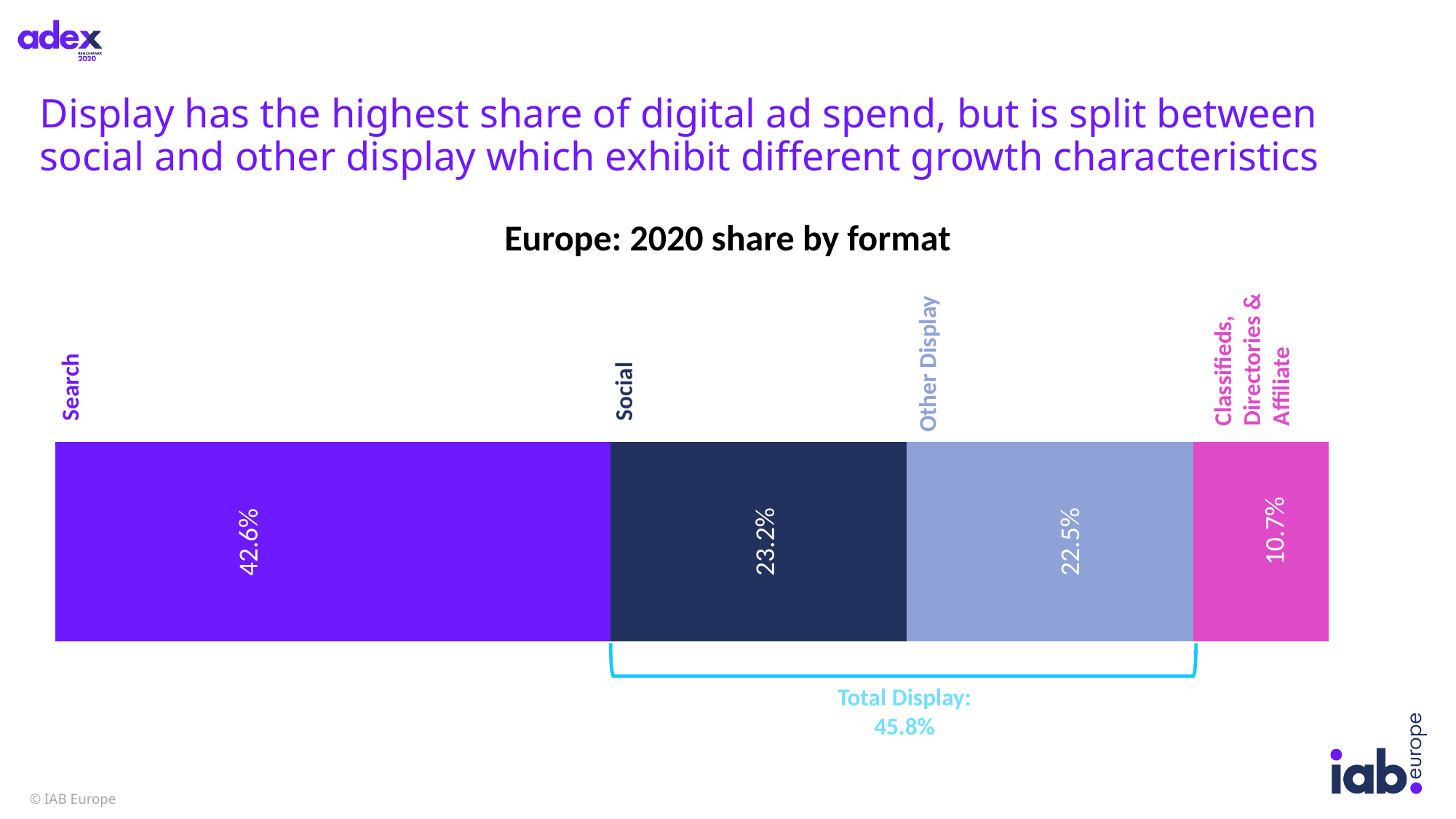
What is the Total Display share labelled below the bar? 45.8% How many format segments are shown in the bar? 4 Which format has the highest share? Search What is the difference between the Search share and the Social share? 19.4% Which format has the lowest share? Classifieds, Directories & Affiliate What is the share for Search? 42.6% What is the share for Other Display? 22.5% What is the difference between the Social share and the Other Display share? 0.7% What is the share for Classifieds, Directories & Affiliate? 10.7% Which is larger, the share for Search or the share for Classifieds, Directories & Affiliate? Search What kind of chart is shown on the slide? Stacked bar chart What is the share for Social? 23.2%